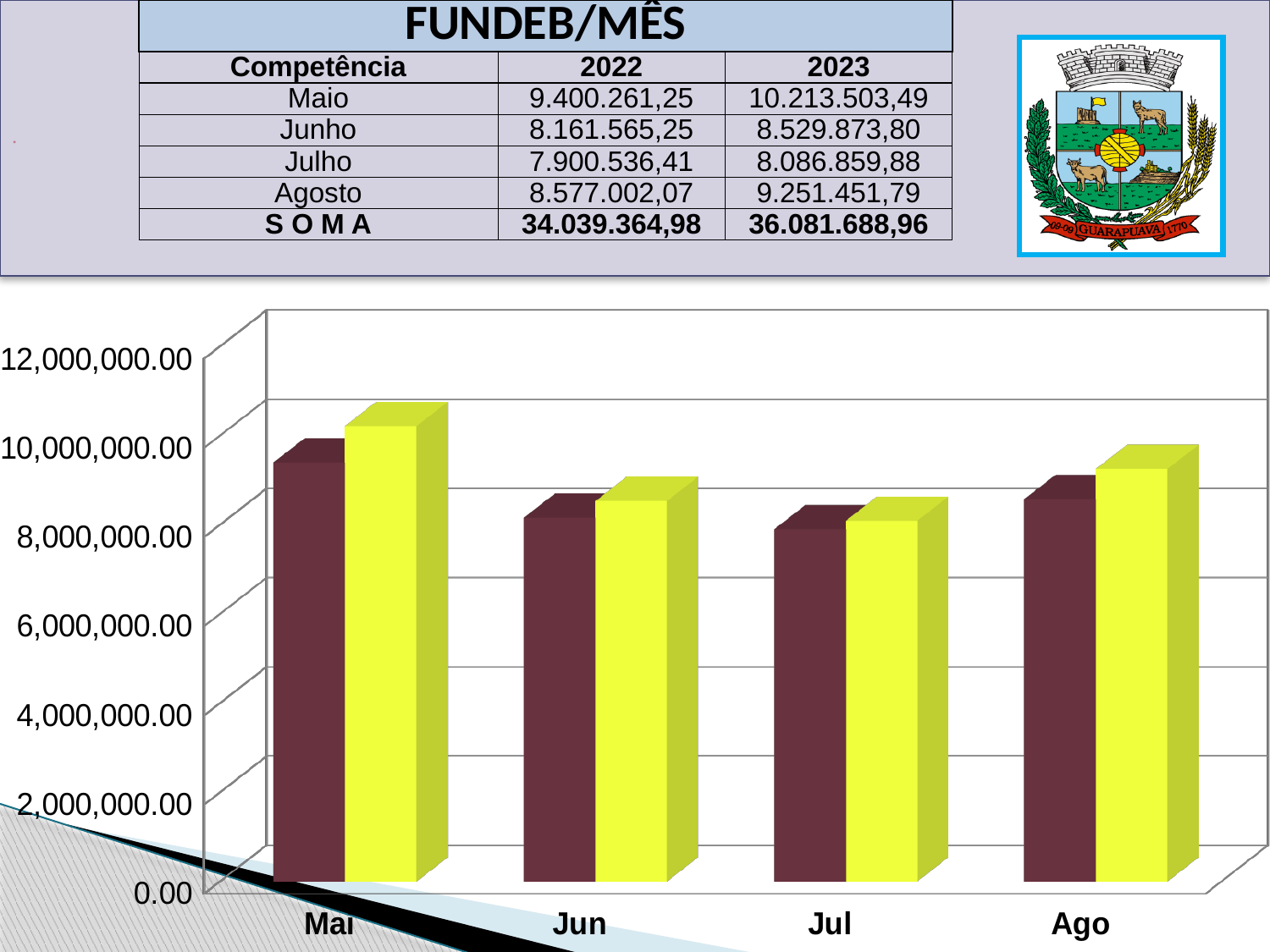
What kind of chart is shown on the slide? bar chart Which month has the shortest bar in the chart? Jul How many bars are plotted for each month in the chart? 2 Is the value of the dark red bar for Mai greater or less than 8,000,000.00? greater Which month has the tallest bar in the chart? Mai How many months are shown on the x axis of the chart? 4 According to the table, what is the difference between the SOMA for 2023 and the SOMA for 2022? 2.042.323,98 Is the value of the yellow bar for Ago greater or less than 10,000,000.00? less Do the dark red bars rise or fall from Mai to Jul? fall According to the table, what is the FUNDEB value for Maio in 2023? 10.213.503,49 Is the value of the yellow bar for Mai greater or less than 10,000,000.00? greater In the chart, which month has the larger dark red bar, Mai or Jun? Mai